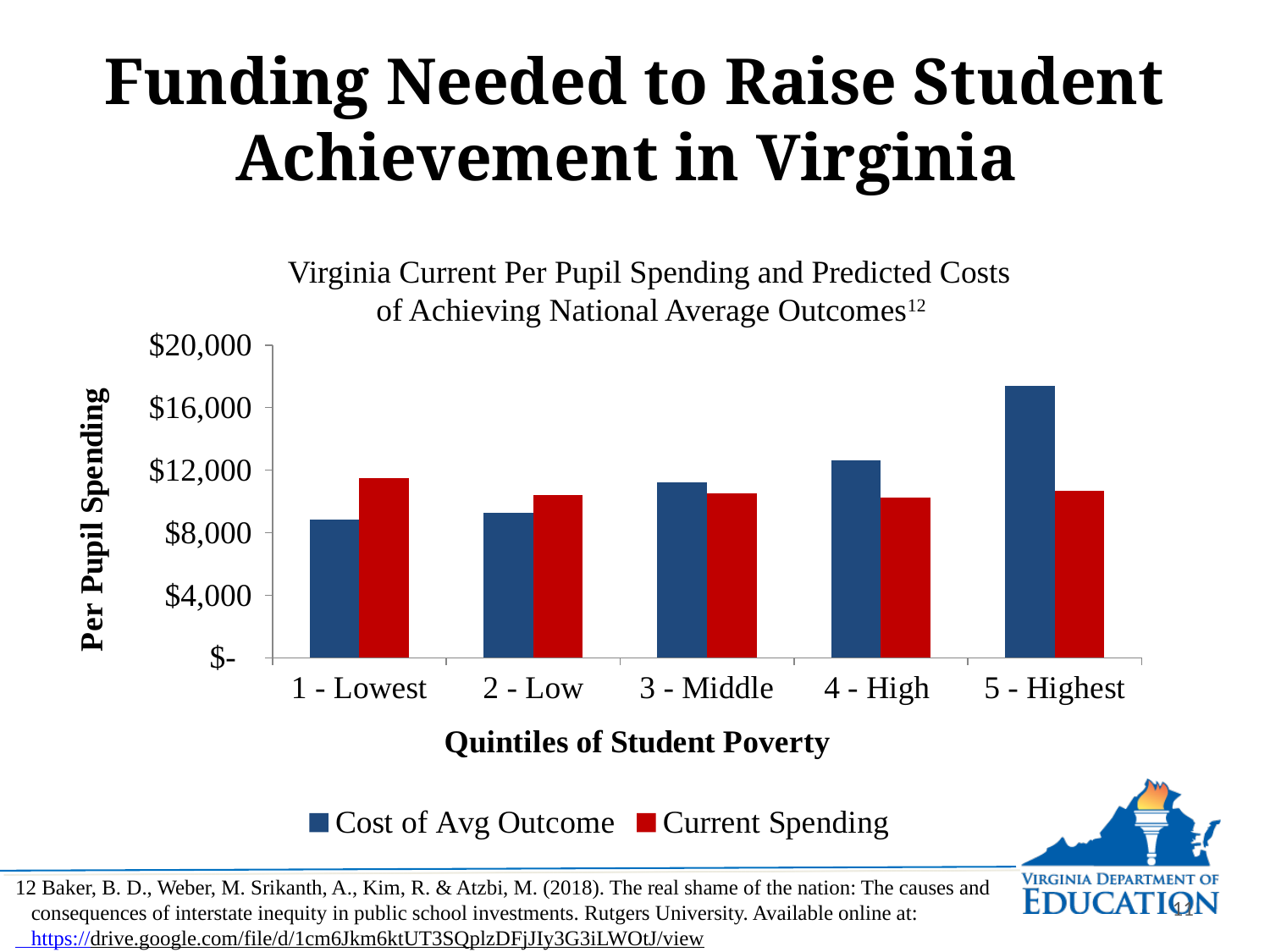
Which quintile has the highest Cost of Avg Outcome? 5 - Highest Is the Cost of Avg Outcome for 1 - Lowest greater or less than $8,000? greater For 5 - Highest, which is larger: Cost of Avg Outcome or Current Spending? Cost of Avg Outcome Is the Current Spending for 1 - Lowest greater or less than $12,000? less How many poverty quintile categories are shown on the x axis? 5 What kind of chart is shown on the slide? Bar chart For 1 - Lowest, which is larger: Cost of Avg Outcome or Current Spending? Current Spending How many series does the chart's legend list? 2 Which quintile has the highest Current Spending? 1 - Lowest Does the Cost of Avg Outcome rise or fall as the poverty quintile increases from 1 - Lowest to 5 - Highest? Rises Is the Cost of Avg Outcome for 5 - Highest greater or less than $16,000? greater Which quintile has the lowest Cost of Avg Outcome? 1 - Lowest